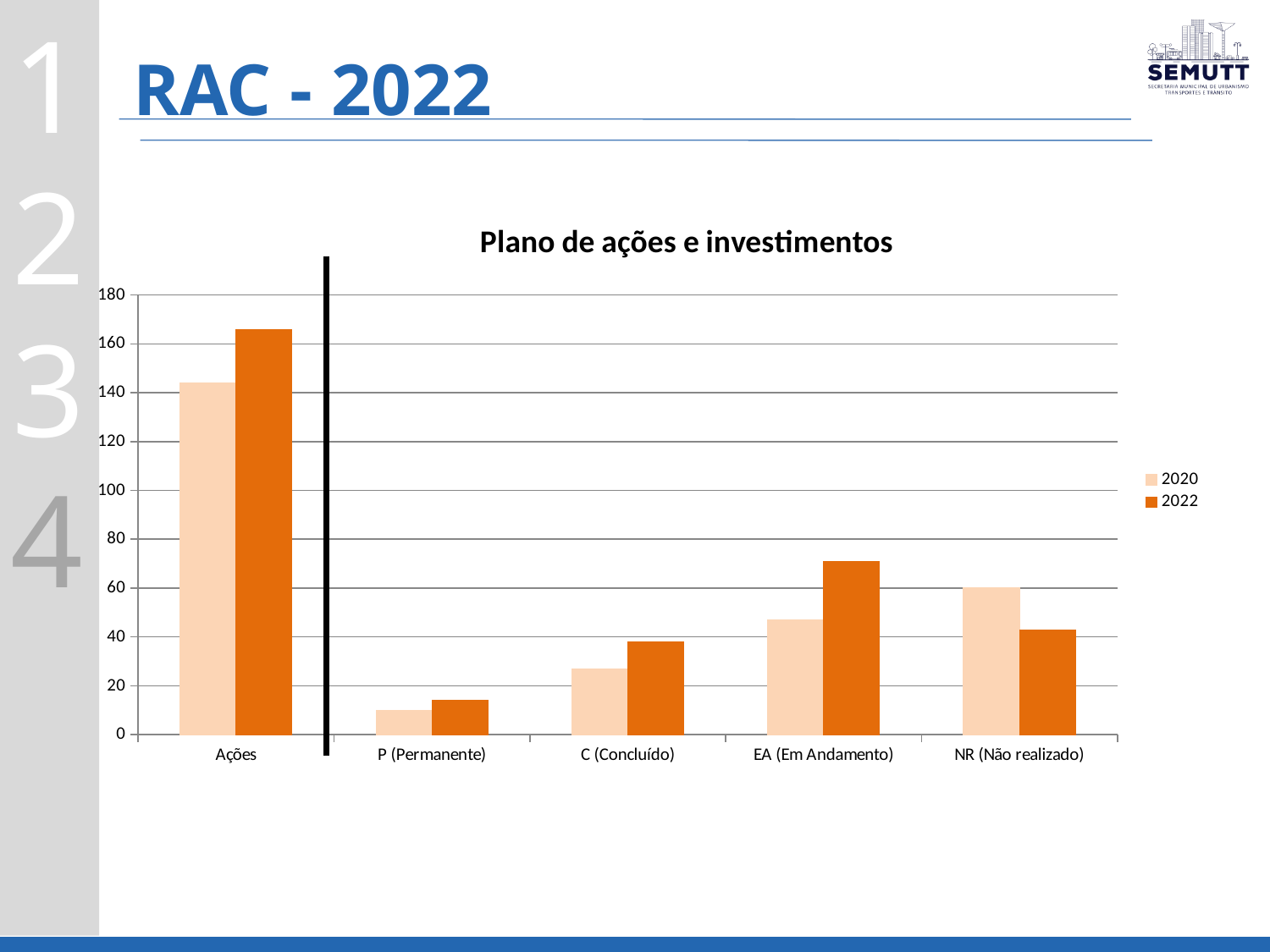
Is the 2022 value for NR (Não realizado) greater or less than 60? less Is the 2022 value for EA (Em Andamento) greater or less than 60? greater Is the 2020 value for P (Permanente) greater or less than 20? less Which category has the lowest value for the 2020 series? P (Permanente) What type of chart is shown on the slide? Bar chart For EA (Em Andamento), which series has the larger value, 2020 or 2022? 2022 What is the title of the chart? Plano de ações e investimentos For NR (Não realizado), which series has the larger value, 2020 or 2022? 2020 Which category has the highest value for the 2022 series? Ações How many series does the legend list? 2 How many categories are shown on the x axis? 5